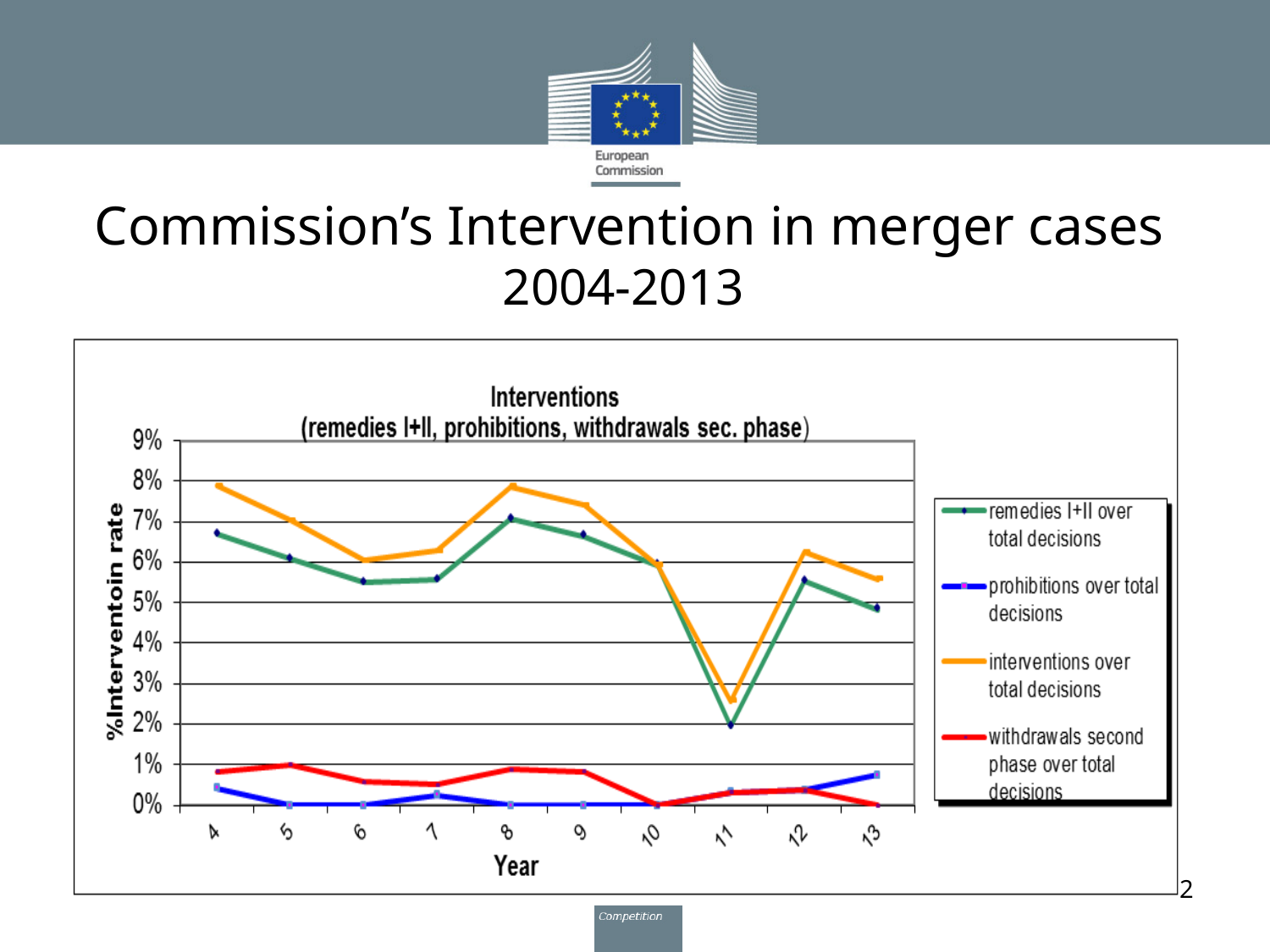
What colour is the line for 'interventions over total decisions'? orange Is the value for 'interventions over total decisions' in year 4 greater or less than 7%? greater What is the value for 'prohibitions over total decisions' in year 10? 0% What kind of chart is shown on the slide? line chart In which year is the value for 'prohibitions over total decisions' highest? 13 How many series does the legend list? 4 Does the value for 'remedies I+II over total decisions' rise or fall from year 8 to year 11? fall In which year is the value for 'remedies I+II over total decisions' lowest? 11 Is the value for 'interventions over total decisions' in year 11 greater or less than 3%? less How many years are plotted along the x axis? 10 In which year is the value for 'interventions over total decisions' lowest? 11 In year 8, which is larger: 'interventions over total decisions' or 'remedies I+II over total decisions'? interventions over total decisions